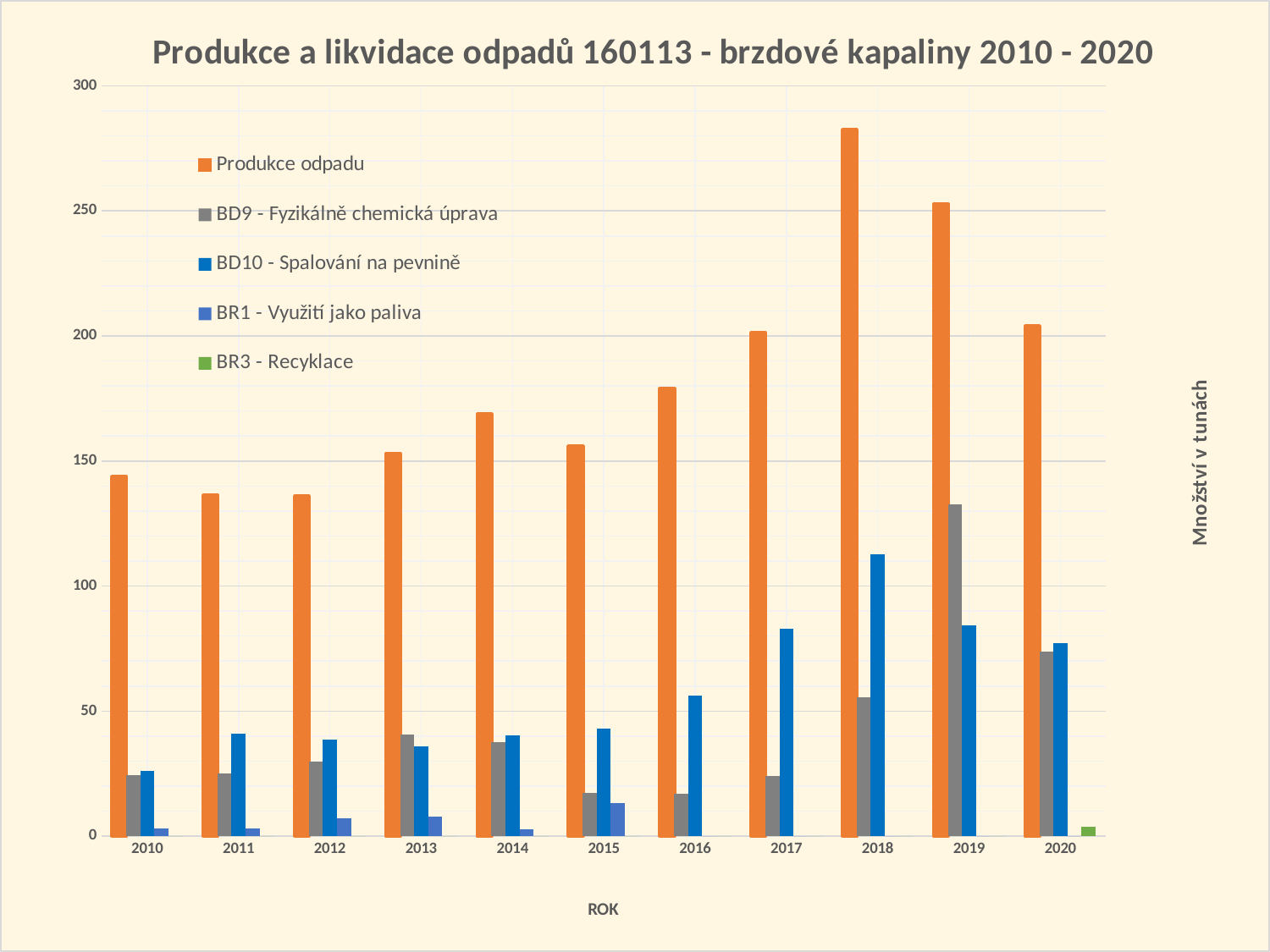
Which year has the larger Produkce odpadu value: 2019 or 2020? 2019 Is the value for Produkce odpadu in 2018 greater or less than 250? greater In which year is Produkce odpadu highest? 2018 What kind of chart is shown on the slide? bar chart In which year is BD9 - Fyzikálně chemická úprava highest? 2019 In 2018, which is larger: BD9 - Fyzikálně chemická úprava or BD10 - Spalování na pevnině? BD10 - Spalování na pevnině What is the title of the vertical axis? Množství v tunách How many years are shown on the x axis? 11 Does Produkce odpadu rise or fall from 2016 to 2018? rise Is the value for BD9 - Fyzikálně chemická úprava in 2019 greater or less than 100? greater Is the value for Produkce odpadu in 2010 greater or less than 150? less How many series does the legend list? 5